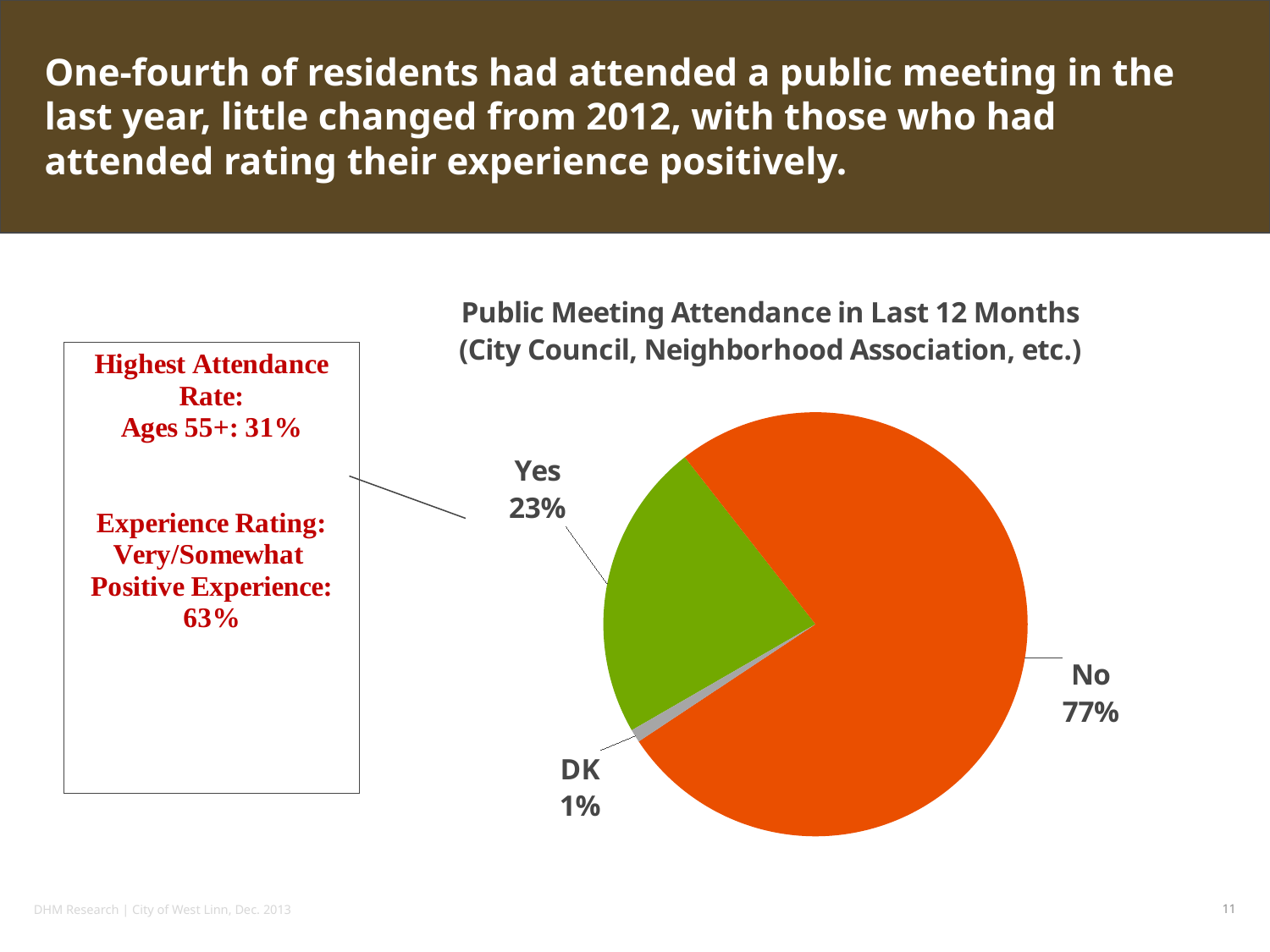
Which category has the largest slice of the pie chart? No Which slice is larger, "Yes" or "No"? No Which category has the smallest slice of the pie chart? DK What type of chart is shown on the slide? Pie chart What share of the pie is labelled "DK"? 1% What is the difference in percentage points between the "No" and "Yes" slices? 54 How many slices does the pie chart have? 3 Is the value for "Yes" greater or less than 50%? less What percentage of residents answered "Yes" to attending a public meeting in the last 12 months? 23% What colour is the "Yes" slice of the pie chart? Green What percentage of residents answered "No" in the Public Meeting Attendance pie chart? 77% What is the title of the chart? Public Meeting Attendance in Last 12 Months (City Council, Neighborhood Association, etc.)